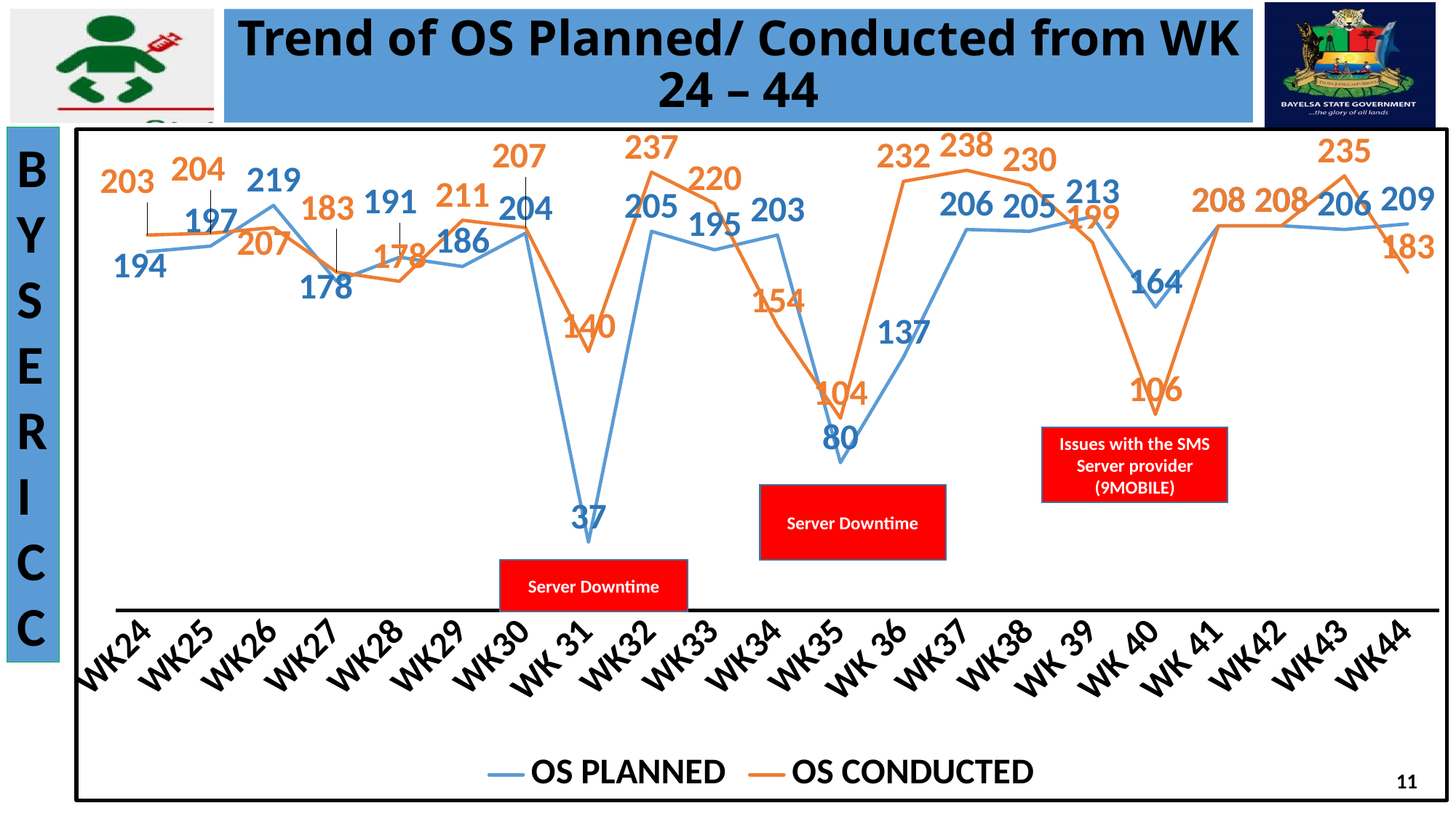
In which week is OS PLANNED lowest? WK 31 What reason does the annotation give for the drop in WK 40? Issues with the SMS Server provider (9MOBILE) How many series does the legend list? 2 What is the OS PLANNED value for WK35? 80 What is the OS CONDUCTED value for WK37? 238 How many weeks are plotted along the x axis? 21 What is the difference between OS CONDUCTED and OS PLANNED in WK 31? 103 What is the OS PLANNED value for WK 31? 37 In WK32, which is larger, OS PLANNED or OS CONDUCTED? OS CONDUCTED What kind of chart is shown on the slide? line chart What is the OS CONDUCTED value for WK 40? 106 In which week is OS CONDUCTED highest? WK37